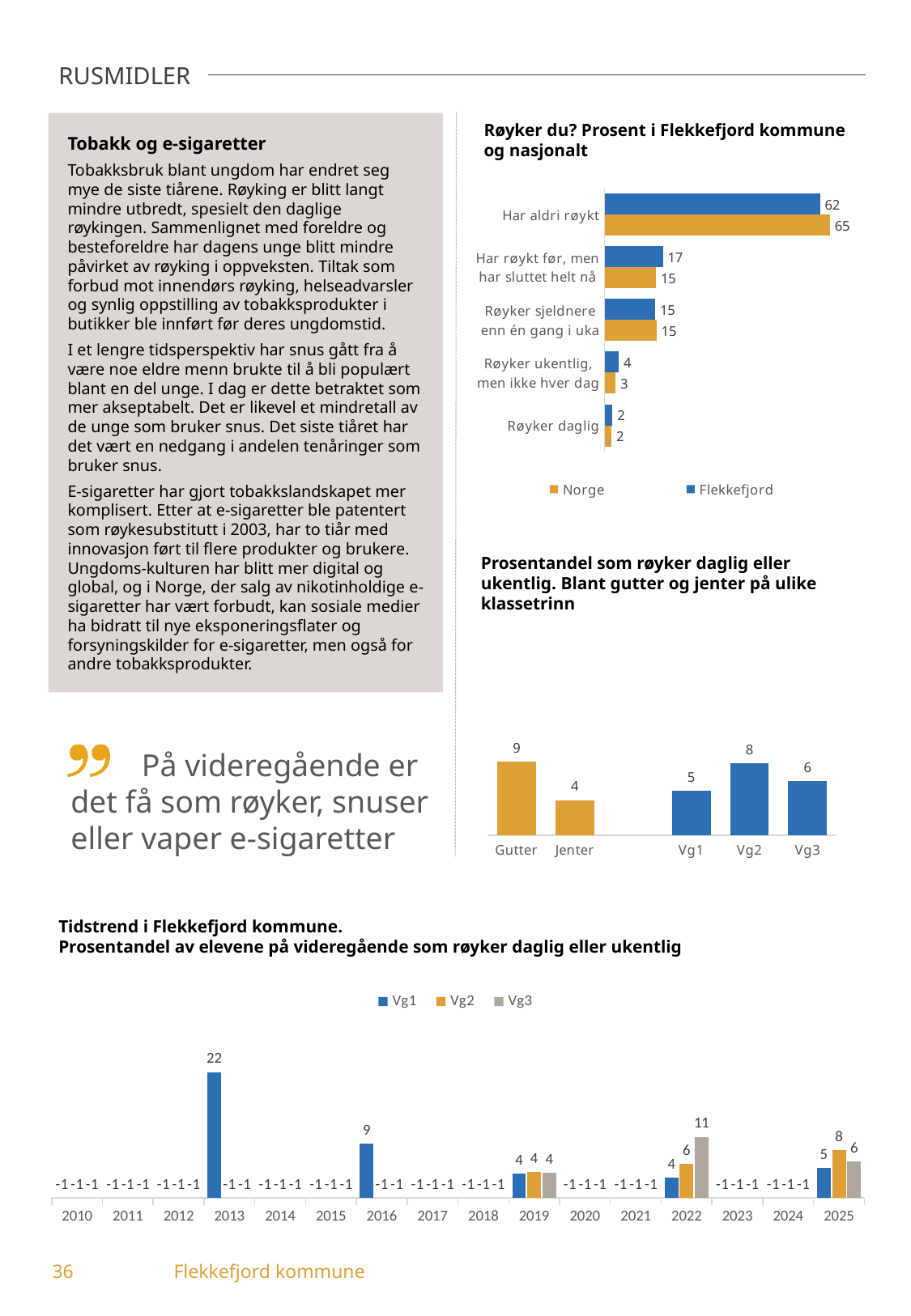
In the chart 'Røyker du? Prosent i Flekkefjord kommune og nasjonalt', how many series does the legend list? 2 In the chart 'Røyker du? Prosent i Flekkefjord kommune og nasjonalt', what is the value for Flekkefjord for 'Har aldri røykt'? 62 In the chart 'Prosentandel som røyker daglig eller ukentlig', which of Vg1, Vg2 and Vg3 has the highest value? Vg2 In the chart 'Prosentandel som røyker daglig eller ukentlig', what is the difference between Gutter and Jenter? 5 In the chart 'Røyker du? Prosent i Flekkefjord kommune og nasjonalt', what is the difference between the Norge and Flekkefjord values for 'Har aldri røykt'? 3 In the chart 'Tidstrend i Flekkefjord kommune', what is the value for Vg3 in 2022? 11 In the chart 'Tidstrend i Flekkefjord kommune', what is the value for Vg1 in 2013? 22 In the chart 'Røyker du? Prosent i Flekkefjord kommune og nasjonalt', what is the value for Norge for 'Har røykt før, men har sluttet helt nå'? 15 In the chart 'Prosentandel som røyker daglig eller ukentlig', what is the value for Gutter? 9 In the chart 'Røyker du? Prosent i Flekkefjord kommune og nasjonalt', which category has the lowest value for Flekkefjord? Røyker daglig What kind of chart is 'Tidstrend i Flekkefjord kommune'? Bar chart In the chart 'Tidstrend i Flekkefjord kommune', which series has the highest value in 2025? Vg2